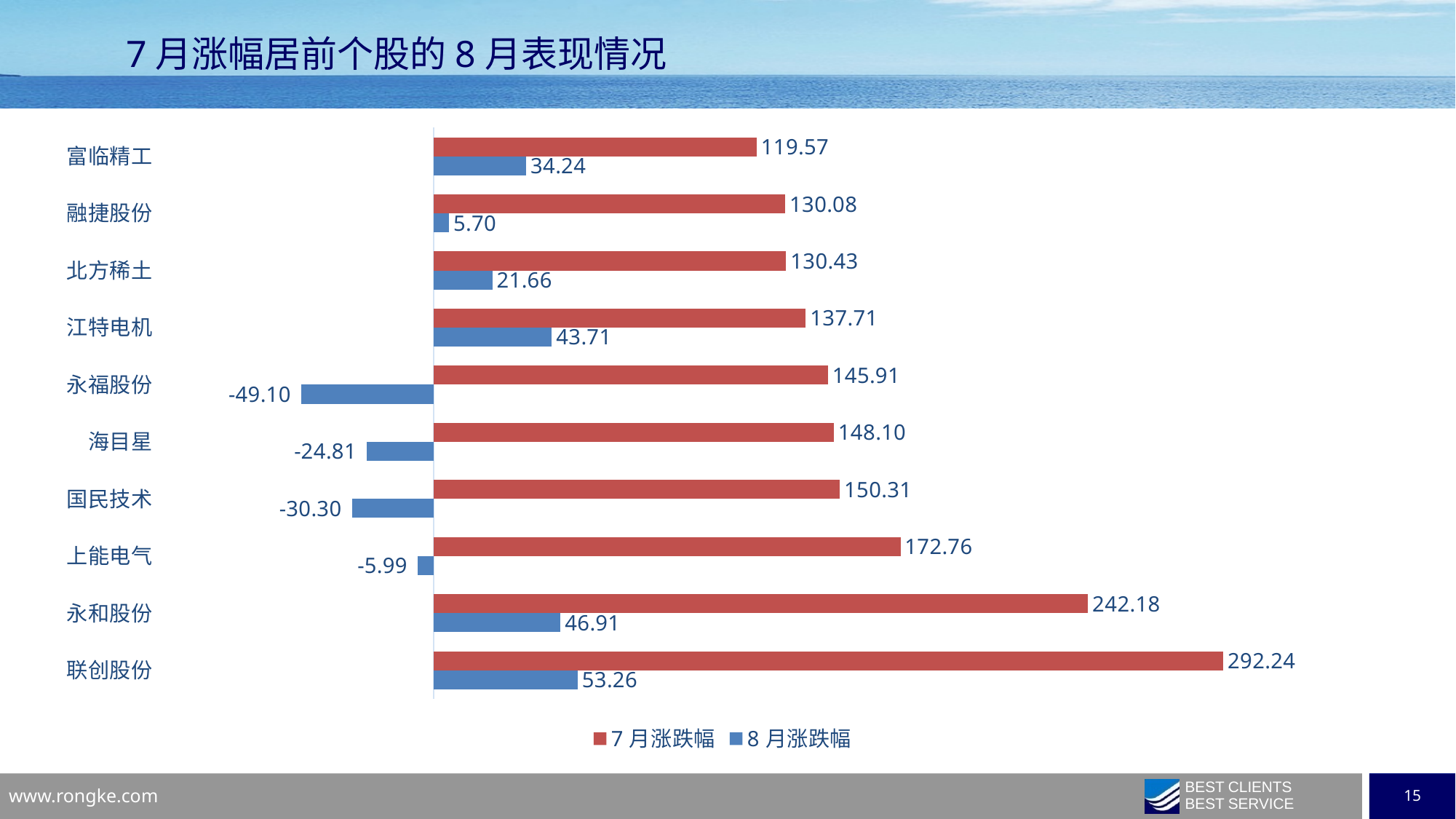
What is the 8月涨跌幅 value for 江特电机? 43.71 Which stock has the lowest 8月涨跌幅? 永福股份 Which colour represents the 8月涨跌幅 series? Blue Which stock has the highest 8月涨跌幅? 联创股份 Which stock has the highest 7月涨跌幅? 联创股份 What is the 7月涨跌幅 value for 联创股份? 292.24 Which is larger, the 8月涨跌幅 for 永和股份 or for 江特电机? 永和股份 How many series does the legend list? 2 What is the difference between the 7月涨跌幅 and 8月涨跌幅 values for 富临精工? 85.33 What kind of chart is shown on the slide? Bar chart How many stocks are shown in the chart? 10 What is the 8月涨跌幅 value for 永福股份? -49.10